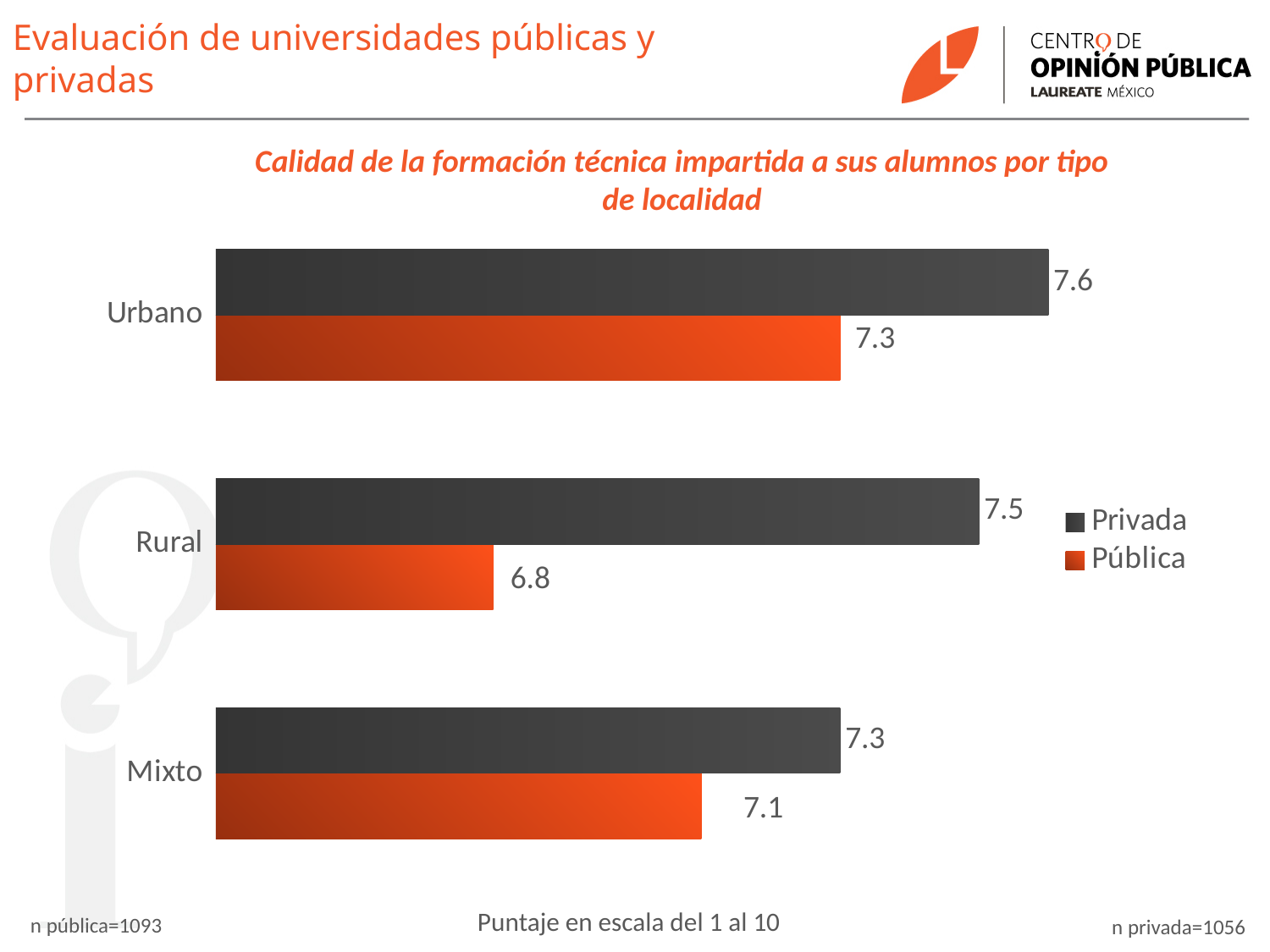
How many locality types are shown on the chart? 3 Which locality type has the lowest Pública value? Rural How many series does the legend list? 2 What is the Pública value for Mixto? 7.1 What is the difference between the Privada and Pública values for Rural? 0.7 What kind of chart is shown on the slide? Bar chart What is the Privada value for Urbano? 7.6 What is the Pública value for Rural? 6.8 What is the Privada value for Mixto? 7.3 Which is larger for Urbano, the Privada value or the Pública value? Privada Which locality type has the highest Privada value? Urbano What is the difference between the Pública values for Urbano and Mixto? 0.2